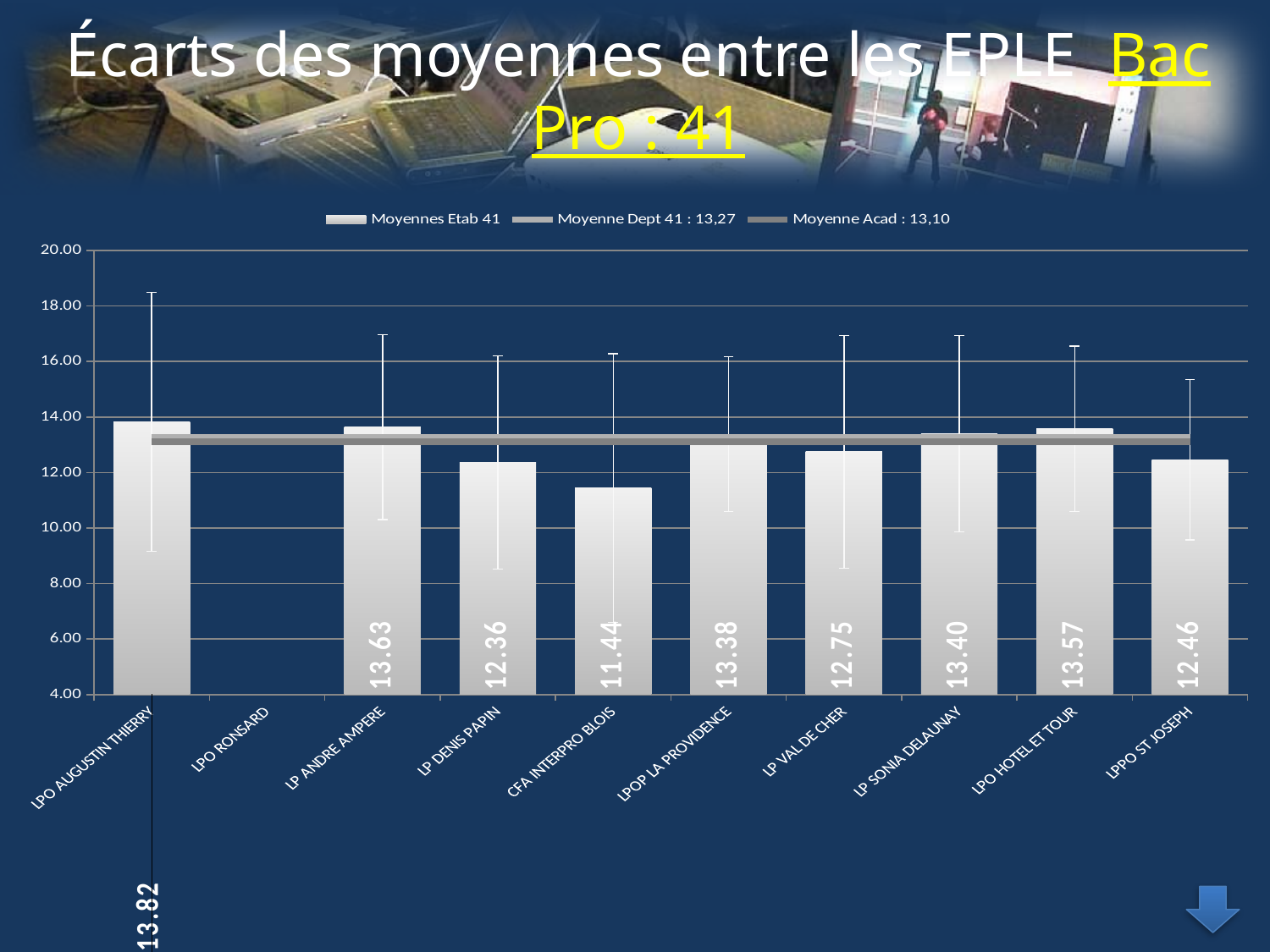
What is the value for LPO AUGUSTIN THIERRY? 13.82 How many series does the legend list? 3 Which is larger, the value for LP ANDRE AMPERE or LP DENIS PAPIN? LP ANDRE AMPERE What is the value for LPO HOTEL ET TOUR? 13.57 Is the value for LPPO ST JOSEPH greater or less than 14.00? less According to the legend, what is the value of Moyenne Dept 41? 13,27 Which establishment has the highest value? LPO AUGUSTIN THIERRY How many establishments are listed on the x axis? 10 Which establishment has the lowest value? CFA INTERPRO BLOIS What kind of chart is shown? bar chart What is the difference between the values for LPO AUGUSTIN THIERRY and CFA INTERPRO BLOIS? 2.38 What is the value for CFA INTERPRO BLOIS? 11.44